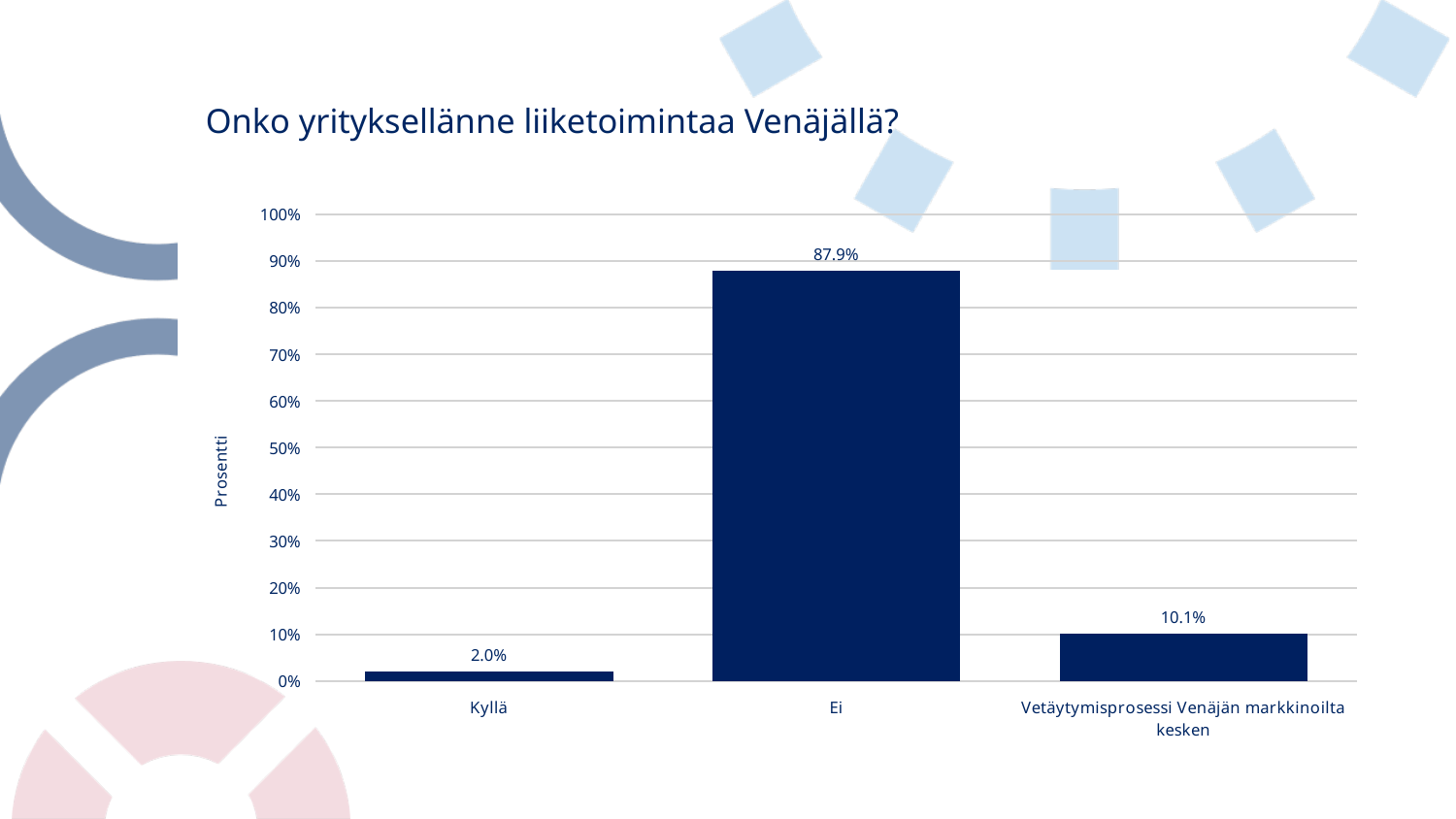
Is the value for "Ei" greater or less than 80%? greater Which category has the highest value? Ei Which category has the lowest value? Kyllä What is the difference between the values for "Vetäytymisprosessi Venäjän markkinoilta kesken" and "Kyllä"? 8.1% What is the value for "Vetäytymisprosessi Venäjän markkinoilta kesken"? 10.1% How many categories are shown on the x axis? 3 What is the difference between the values for "Ei" and "Vetäytymisprosessi Venäjän markkinoilta kesken"? 77.8% What is the value for "Kyllä"? 2.0% Which is larger, the value for "Kyllä" or the value for "Vetäytymisprosessi Venäjän markkinoilta kesken"? Vetäytymisprosessi Venäjän markkinoilta kesken What is the value for "Ei"? 87.9% What kind of chart is shown on the slide? bar chart What is the title of the chart? Onko yrityksellänne liiketoimintaa Venäjällä?